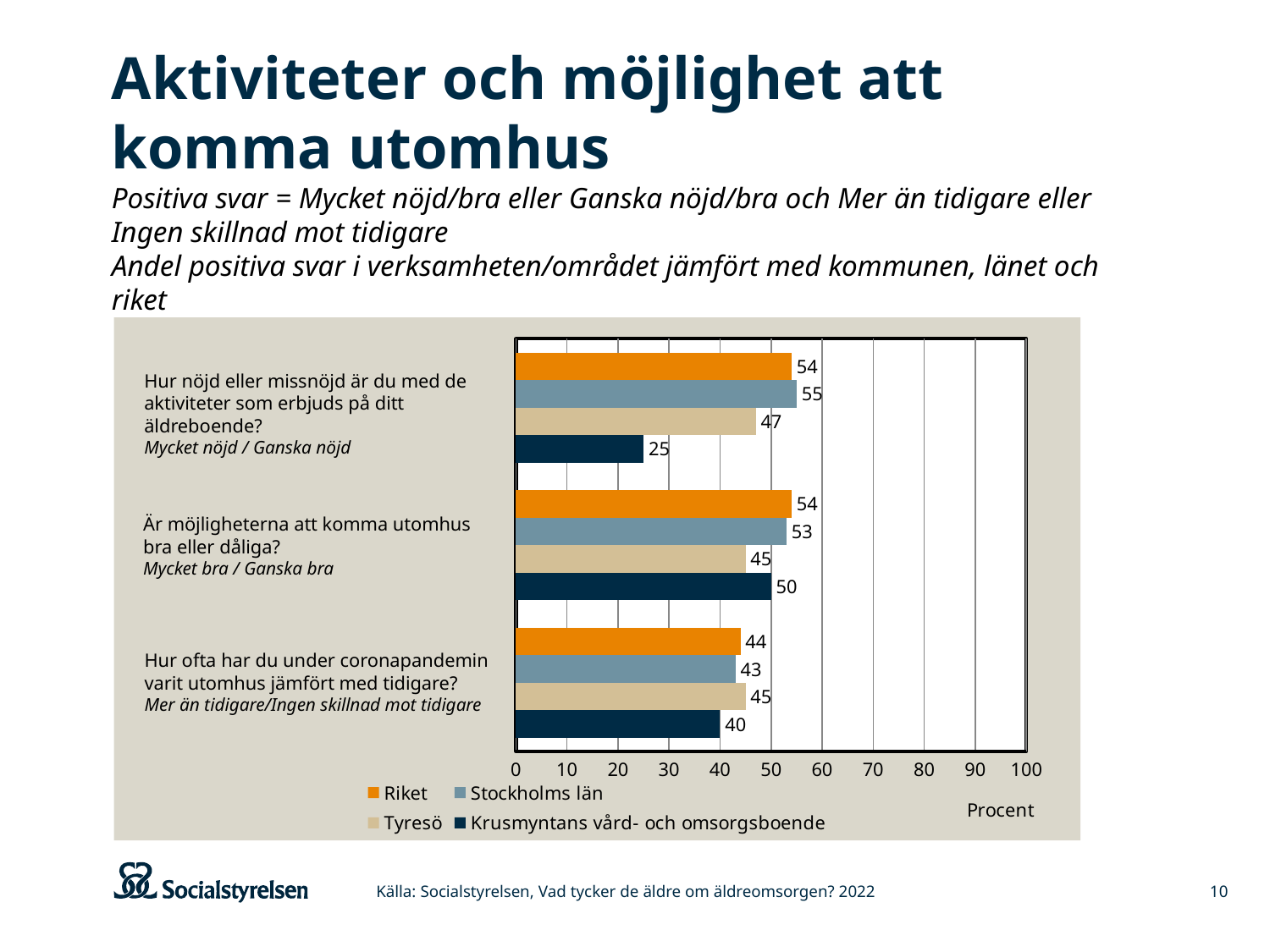
Is the value for Krusmyntans vård- och omsorgsboende for the question "Hur nöjd eller missnöjd är du med de aktiviteter som erbjuds på ditt äldreboende?" greater or less than 30? less What is the value for Tyresö for the question "Hur ofta har du under coronapandemin varit utomhus jämfört med tidigare?"? 45 How many question categories are shown on the chart? 3 Which series has the highest value for the question "Hur nöjd eller missnöjd är du med de aktiviteter som erbjuds på ditt äldreboende?"? Stockholms län What is the value for Stockholms län for the question "Är möjligheterna att komma utomhus bra eller dåliga?"? 53 What is the value for Krusmyntans vård- och omsorgsboende for the question "Hur nöjd eller missnöjd är du med de aktiviteter som erbjuds på ditt äldreboende?"? 25 What kind of chart is shown on the slide? bar chart What unit label is shown under the x axis of the chart? Procent Which series has the lowest value for the question "Hur ofta har du under coronapandemin varit utomhus jämfört med tidigare?"? Krusmyntans vård- och omsorgsboende What is the difference between the Riket value and the Krusmyntans vård- och omsorgsboende value for the question "Hur nöjd eller missnöjd är du med de aktiviteter som erbjuds på ditt äldreboende?"? 29 For the question "Är möjligheterna att komma utomhus bra eller dåliga?", which is larger: the value for Tyresö or the value for Krusmyntans vård- och omsorgsboende? Krusmyntans vård- och omsorgsboende How many series does the legend list? 4